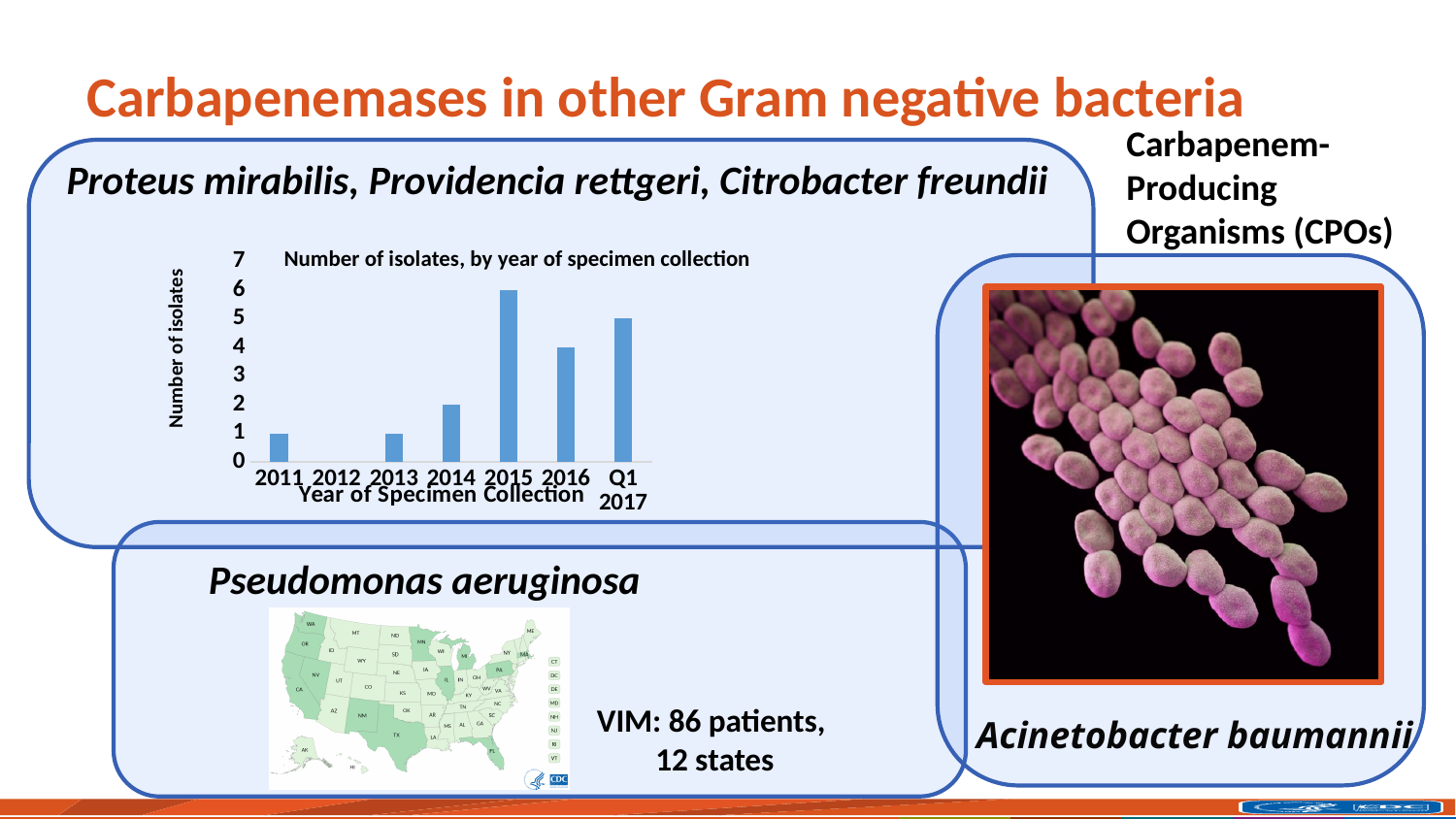
What is the number of isolates for 2015? 6 How many year categories are shown on the x axis of the chart? 7 Do the number of isolates rise or fall from 2013 to 2015? rise Which has more isolates, 2016 or Q1 2017? Q1 2017 What kind of chart is shown on the slide? bar chart Is the number of isolates for 2015 greater or less than 5? greater What is the difference in number of isolates between 2015 and 2016? 2 What is the title of the chart on the slide? Number of isolates, by year of specimen collection What is the number of isolates for 2016? 4 What is the number of isolates for 2014? 2 Which year has the highest number of isolates in the chart? 2015 What is the number of isolates for Q1 2017? 5